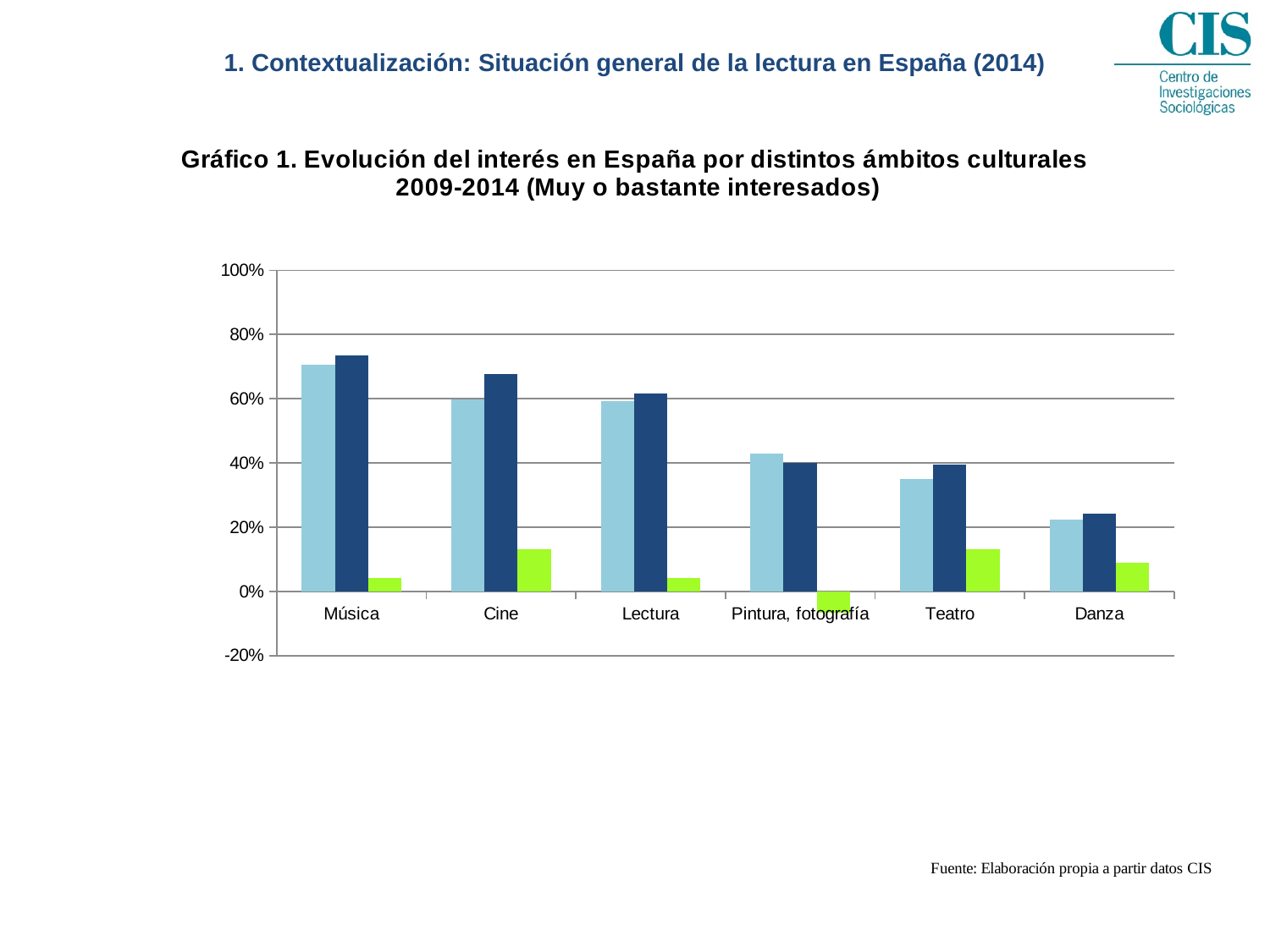
What kind of chart is shown on the slide? bar chart Is the dark blue bar for Música greater or less than 60%? greater Is the dark blue bar for Cine greater or less than 60%? greater Which has the larger dark blue bar, Música or Cine? Música Which category has the tallest dark blue bar? Música How many bars are plotted for each category in the chart? 3 Is the light blue bar for Danza greater or less than 40%? less Which category has the shortest light blue bar? Danza How many categories are shown on the x axis of the chart? 6 Which category has a green bar that goes below 0%? Pintura, fotografía Do the light blue bars rise or fall moving from Música to Danza along the x axis? fall